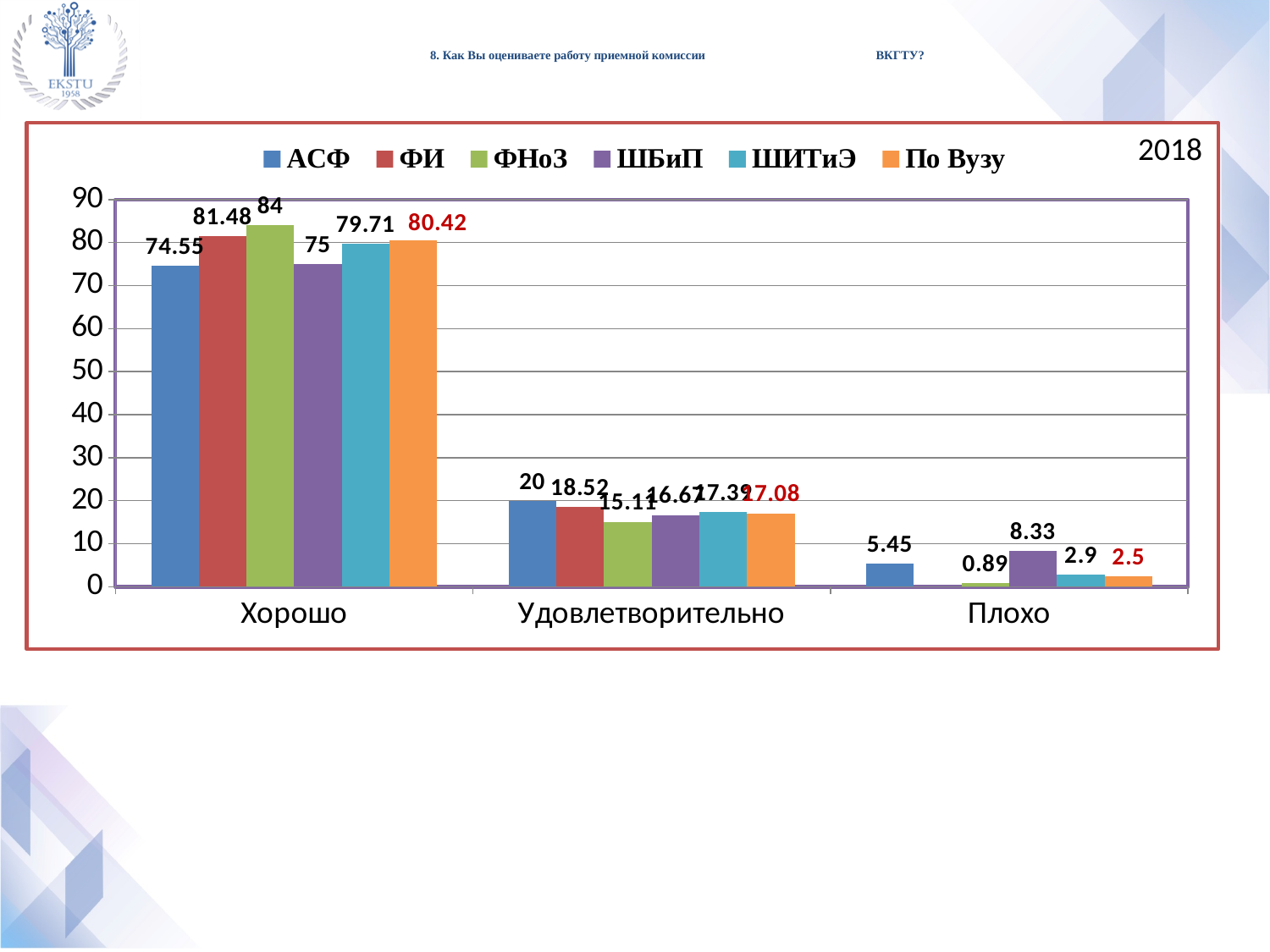
Which series has the highest value in the Хорошо category? ФНоЗ How many categories are shown on the x axis? 3 What is the value for ФНоЗ in the Плохо category? 0.89 What is the value for По Вузу in the Хорошо category? 80.42 What is the difference between the ФИ and АСФ values in the Хорошо category? 6.93 What kind of chart is shown on the slide? bar chart How many series does the legend list? 6 In the Плохо category, which is larger: АСФ or ШБиП? ШБиП What is the value for ШБиП in the Плохо category? 8.33 What is the value for ФНоЗ in the Хорошо category? 84 Which series has the highest value in the Удовлетворительно category? АСФ Is the value for ШИТиЭ in the Хорошо category greater or less than 70? greater